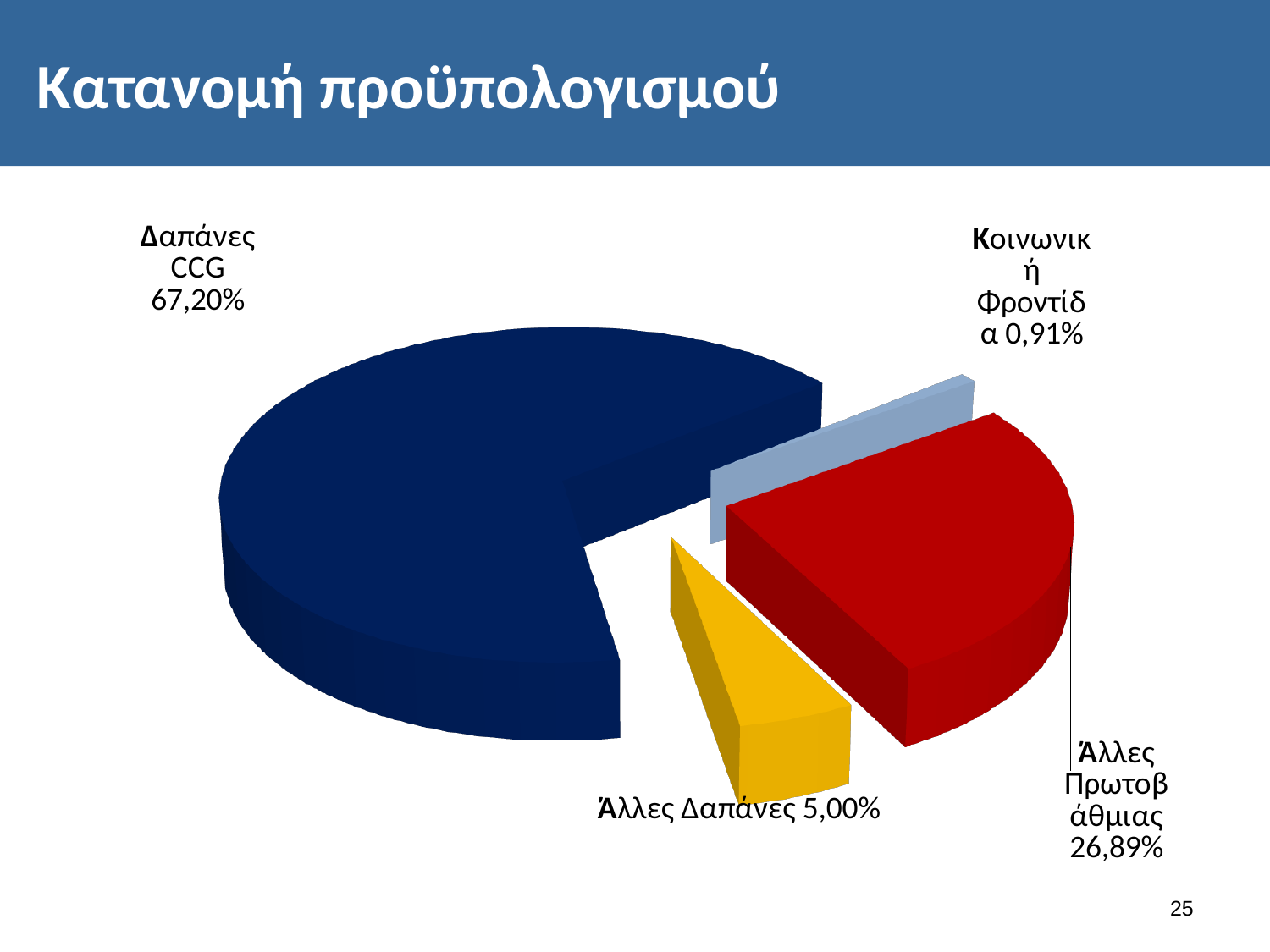
How many slices does the pie chart have? 4 Which category has the largest share of the pie? Δαπάνες CCG What is the title of the chart on the slide? Κατανομή προϋπολογισμού What is the difference in percentage points between Δαπάνες CCG and Άλλες Πρωτοβάθμιας? 40,31 Which is larger, the share for Άλλες Δαπάνες or the share for Κοινωνική Φροντίδα? Άλλες Δαπάνες What kind of chart is shown on the slide? pie chart What share of the budget is labelled Κοινωνική Φροντίδα? 0,91% Which category has the smallest share of the pie? Κοινωνική Φροντίδα What colour is the slice for Δαπάνες CCG? dark blue What share of the budget is labelled Δαπάνες CCG? 67,20% What share of the budget is labelled Άλλες Δαπάνες? 5,00% What share of the budget is labelled Άλλες Πρωτοβάθμιας? 26,89%